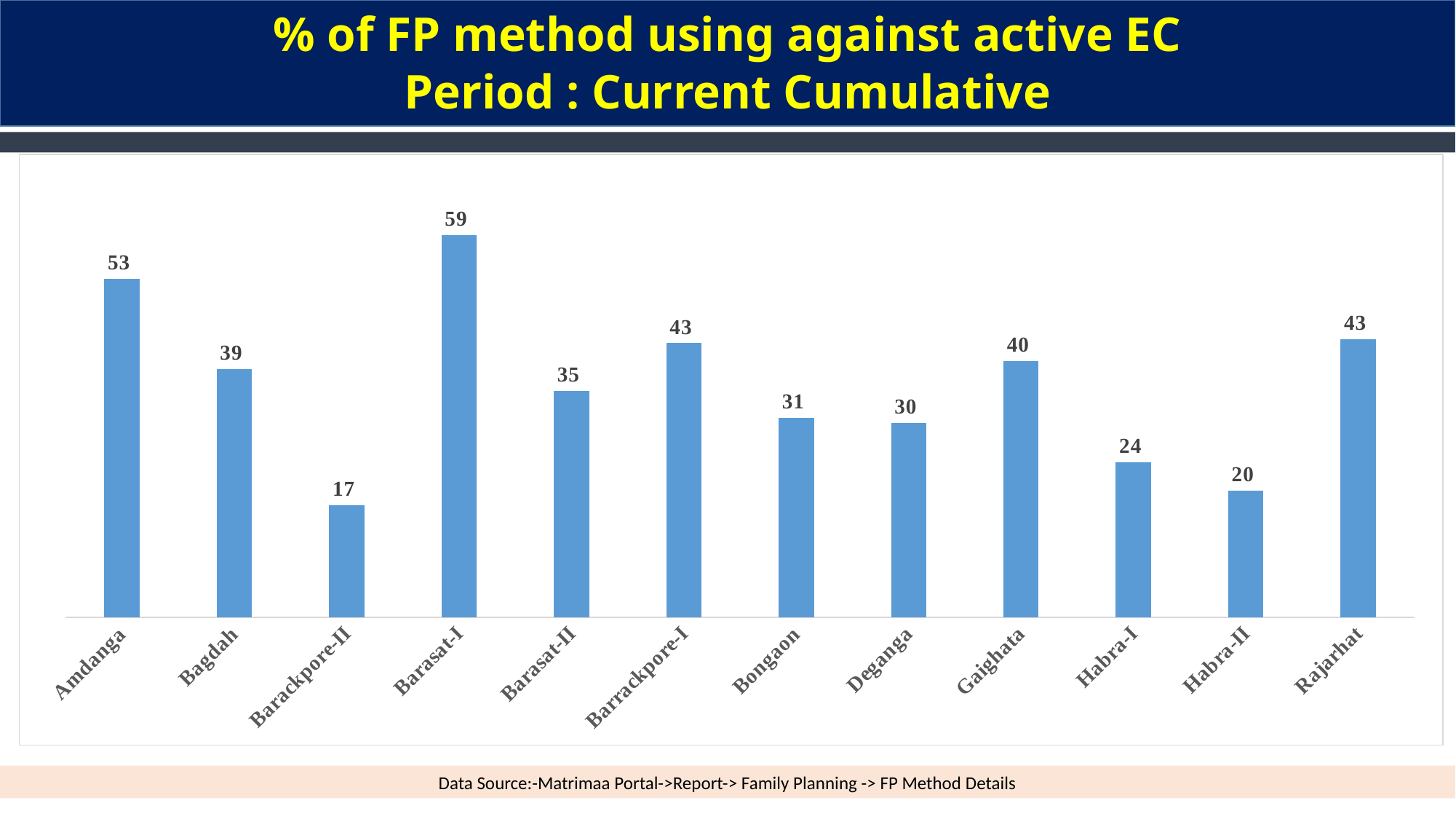
How many categories are shown on the x axis? 12 What kind of chart is shown on the slide? Bar chart Which is larger, the value for Bongaon or the value for Habra-I? Bongaon What is the value for Habra-II? 20 What is the difference between the values for Barasat-I and Barackpore-II? 42 Which category has the lowest value? Barackpore-II What is the value for Barasat-I? 59 What is the value for Gaighata? 40 What is the difference between the values for Amdanga and Bagdah? 14 Which category has the highest value? Barasat-I What is the title of the slide? % of FP method using against active EC Period : Current Cumulative Which is larger, the value for Barasat-II or the value for Barrackpore-I? Barrackpore-I